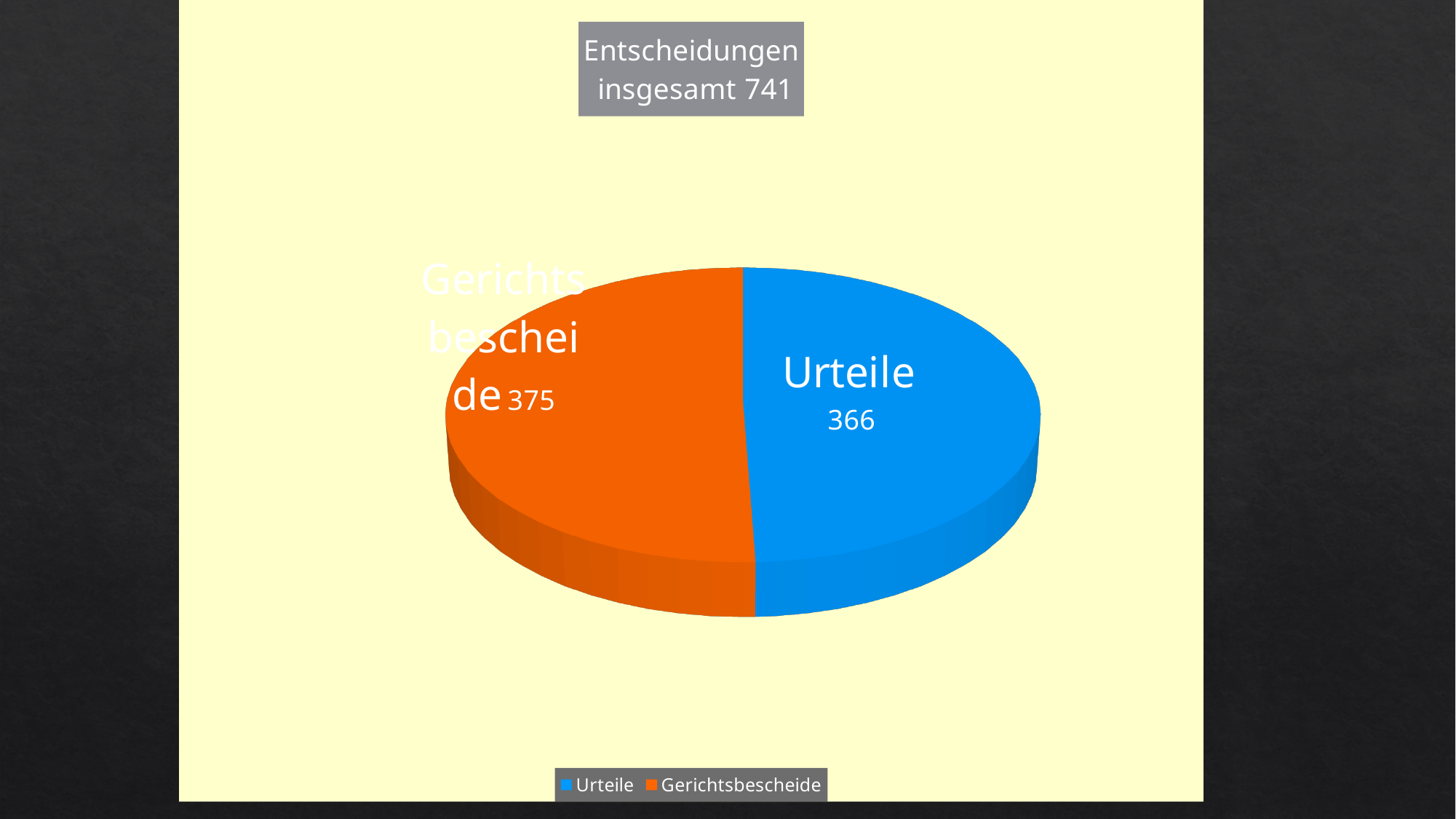
Which category has the largest slice? Gerichtsbescheide How many slices does the pie chart have? 2 What type of chart is shown on the slide? pie chart What is the difference between the values for Gerichtsbescheide and Urteile? 9 What is the title of the chart? Entscheidungen insgesamt 741 Which category has the smallest slice? Urteile Which is larger, Urteile or Gerichtsbescheide? Gerichtsbescheide What is the total of the two slices? 741 How many entries does the legend list? 2 Which colour represents Urteile in the chart? blue What is the value for Gerichtsbescheide? 375 What is the value for Urteile? 366